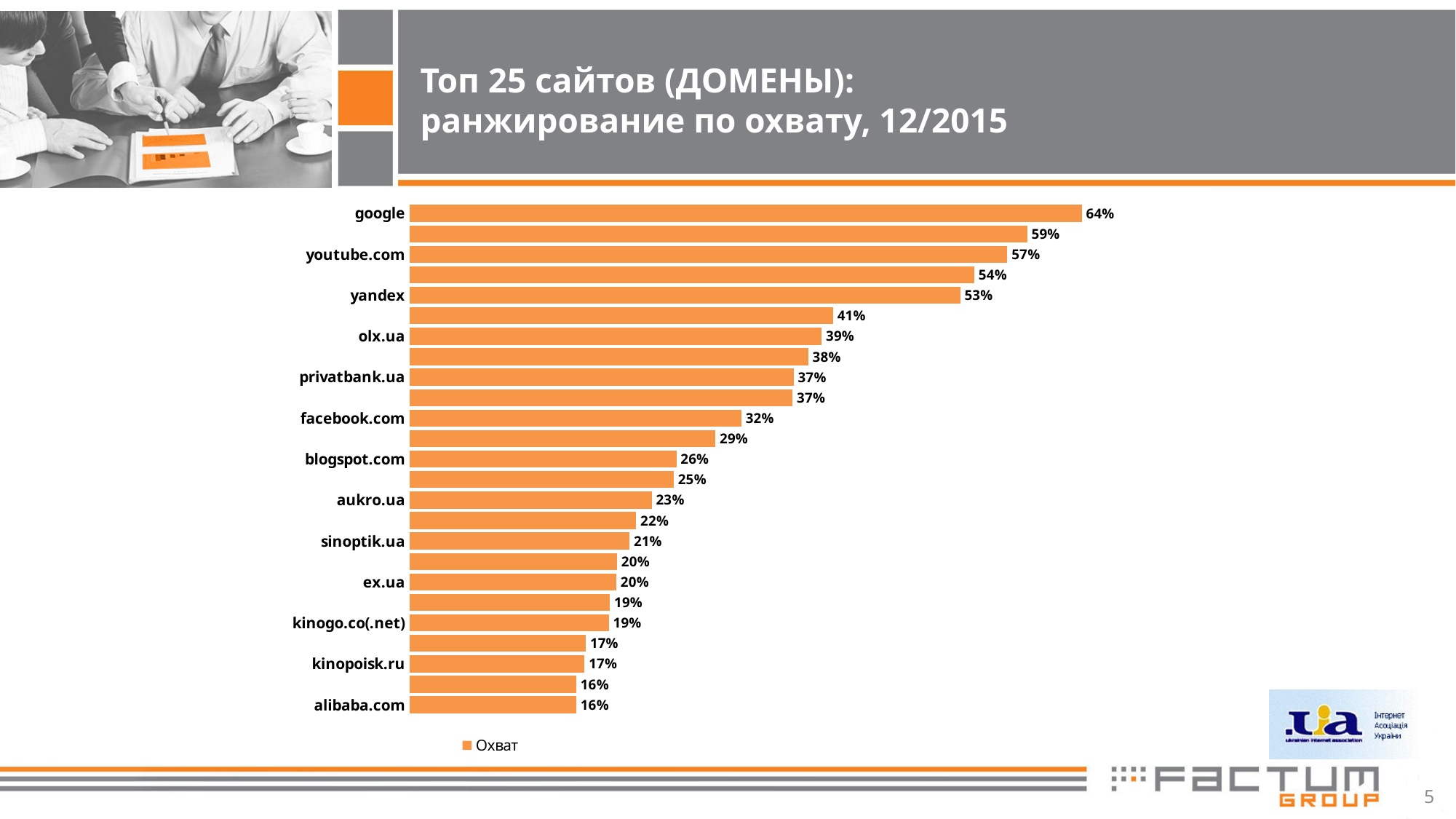
How many bars are plotted on the chart? 25 What is the difference between the values for google and youtube.com? 7% Which site has the highest value? google What is the value for youtube.com? 57% What is the lowest value shown on the chart? 16% What is the value for google? 64% What is the value for sinoptik.ua? 21% What is the value for facebook.com? 32% What is the value for privatbank.ua? 37% What kind of chart is shown on the slide? bar chart Which is larger, the value for yandex or the value for olx.ua? yandex How many series does the legend list? 1